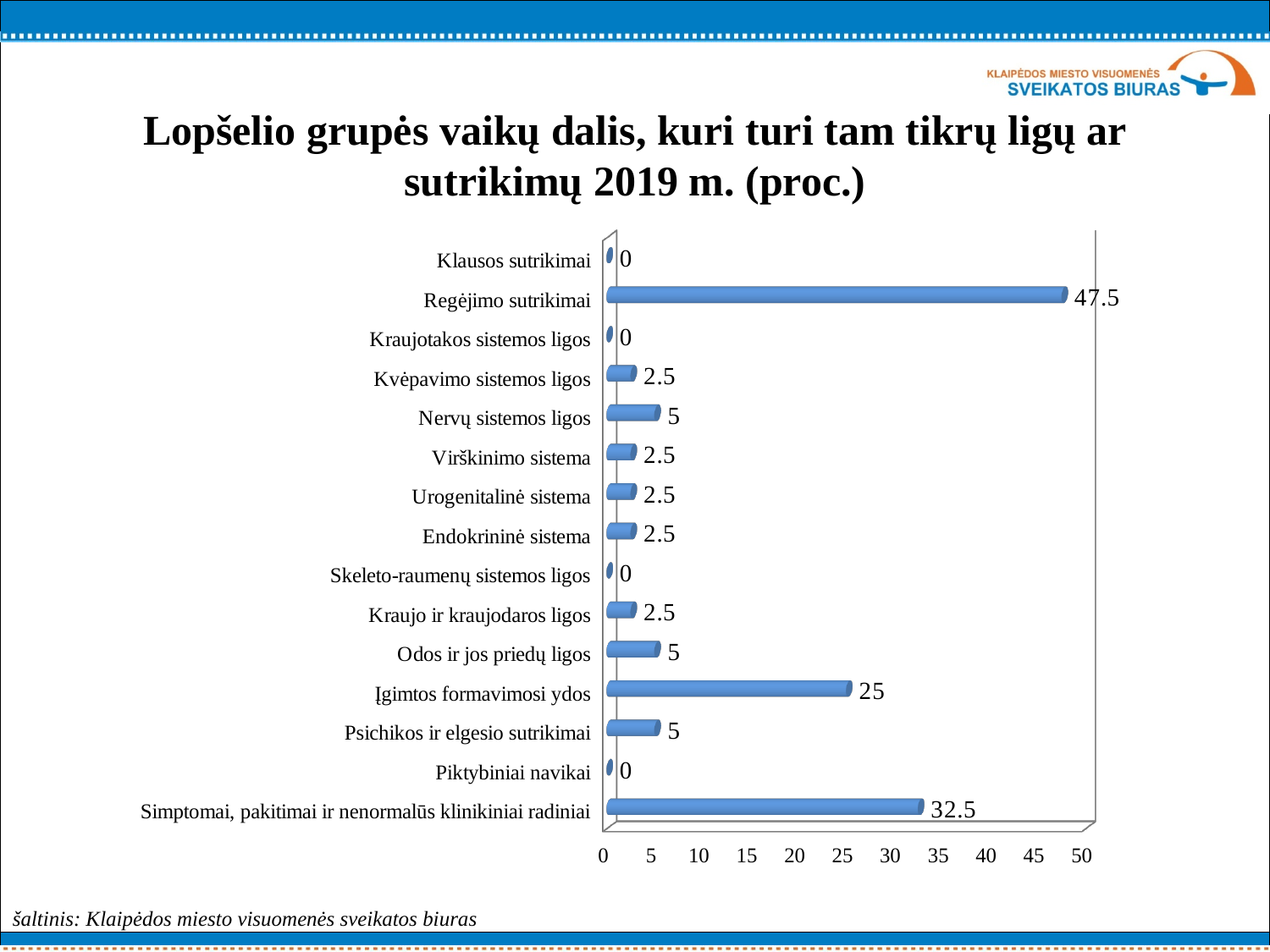
How many categories are shown on the chart? 15 Which category has the highest value? Regėjimo sutrikimai What is the value for Simptomai, pakitimai ir nenormalūs klinikiniai radiniai? 32.5 What is the difference between the values for Įgimtos formavimosi ydos and Odos ir jos priedų ligos? 20 What kind of chart is shown on the slide? Bar chart What is the value for Įgimtos formavimosi ydos? 25 How many categories have a value of 0? 4 What is the value for Regėjimo sutrikimai? 47.5 What is the value for Nervų sistemos ligos? 5 What is the difference between the values for Regėjimo sutrikimai and Simptomai, pakitimai ir nenormalūs klinikiniai radiniai? 15 What is the value for Kvėpavimo sistemos ligos? 2.5 Which is larger, the value for Įgimtos formavimosi ydos or the value for Simptomai, pakitimai ir nenormalūs klinikiniai radiniai? Simptomai, pakitimai ir nenormalūs klinikiniai radiniai